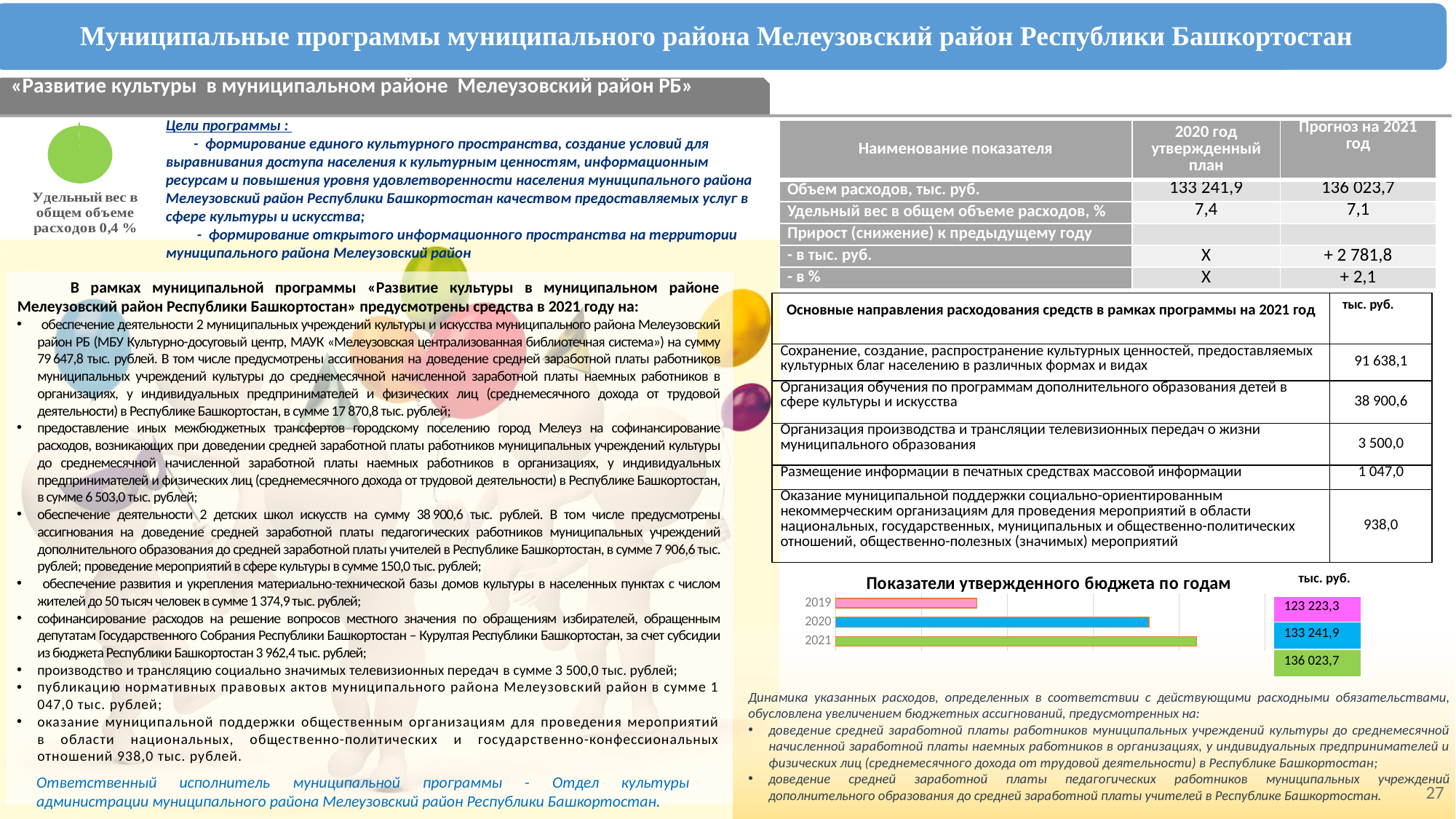
In the chart 'Показатели утвержденного бюджета по годам', what is the difference between the 2021 and 2020 values? 2 781,8 What type of chart is 'Показатели утвержденного бюджета по годам'? Bar chart How many years (bars) are shown in the chart 'Показатели утвержденного бюджета по годам'? 3 In the chart 'Показатели утвержденного бюджета по годам', what is the difference between the 2020 and 2019 values? 10 018,6 In the chart 'Показатели утвержденного бюджета по годам', what is the value for 2020? 133 241,9 What unit is indicated next to the chart 'Показатели утвержденного бюджета по годам'? тыс. руб. In the chart 'Показатели утвержденного бюджета по годам', what is the value for 2019? 123 223,3 In the chart 'Показатели утвержденного бюджета по годам', do the values rise or fall from 2019 to 2021? Rise In the chart 'Показатели утвержденного бюджета по годам', which is larger: the value for 2019 or the value for 2021? 2021 In the chart 'Показатели утвержденного бюджета по годам', which year has the lowest value? 2019 In the chart 'Показатели утвержденного бюджета по годам', what is the value for 2021? 136 023,7 In the chart 'Показатели утвержденного бюджета по годам', which year has the highest value? 2021